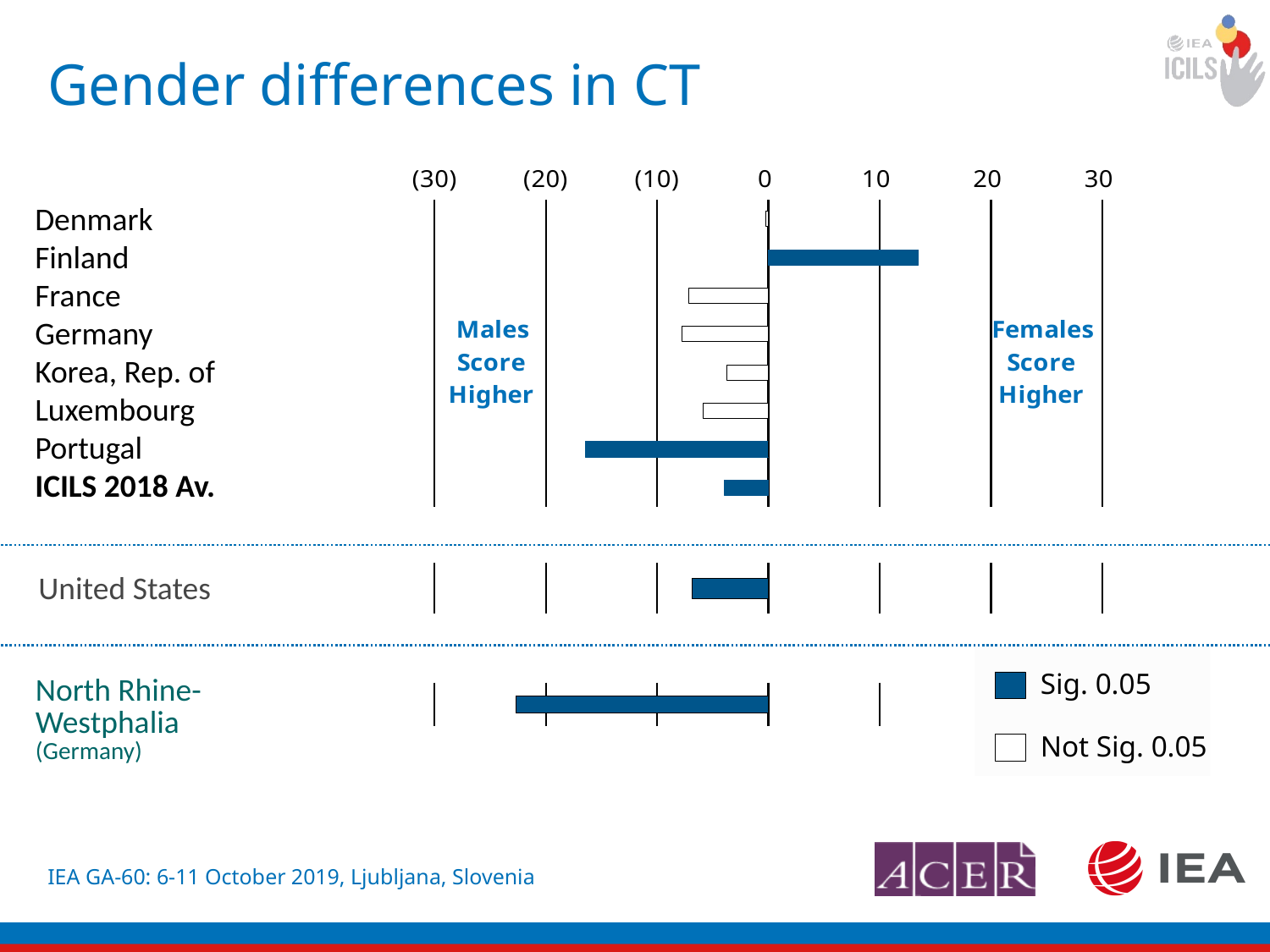
Is the value for Germany greater or less than 0? less What kind of chart is shown on the slide? bar chart How many categories (countries, averages and regions) are plotted on the slide in total? 10 Among the countries in the top panel (Denmark through ICILS 2018 Av.), which has the lowest value? Portugal Which has the larger value, Finland or Portugal? Finland How many entries does the legend list? 2 Which category has the highest value (the largest female advantage) in the chart? Finland Is the value for North Rhine-Westphalia (Germany) greater or less than (10)? less Is the value for Portugal greater or less than (10)? less What does a white (unfilled) bar indicate according to the legend? Not Sig. 0.05 Which category has the lowest value (the largest male advantage) across the whole chart? North Rhine-Westphalia (Germany)